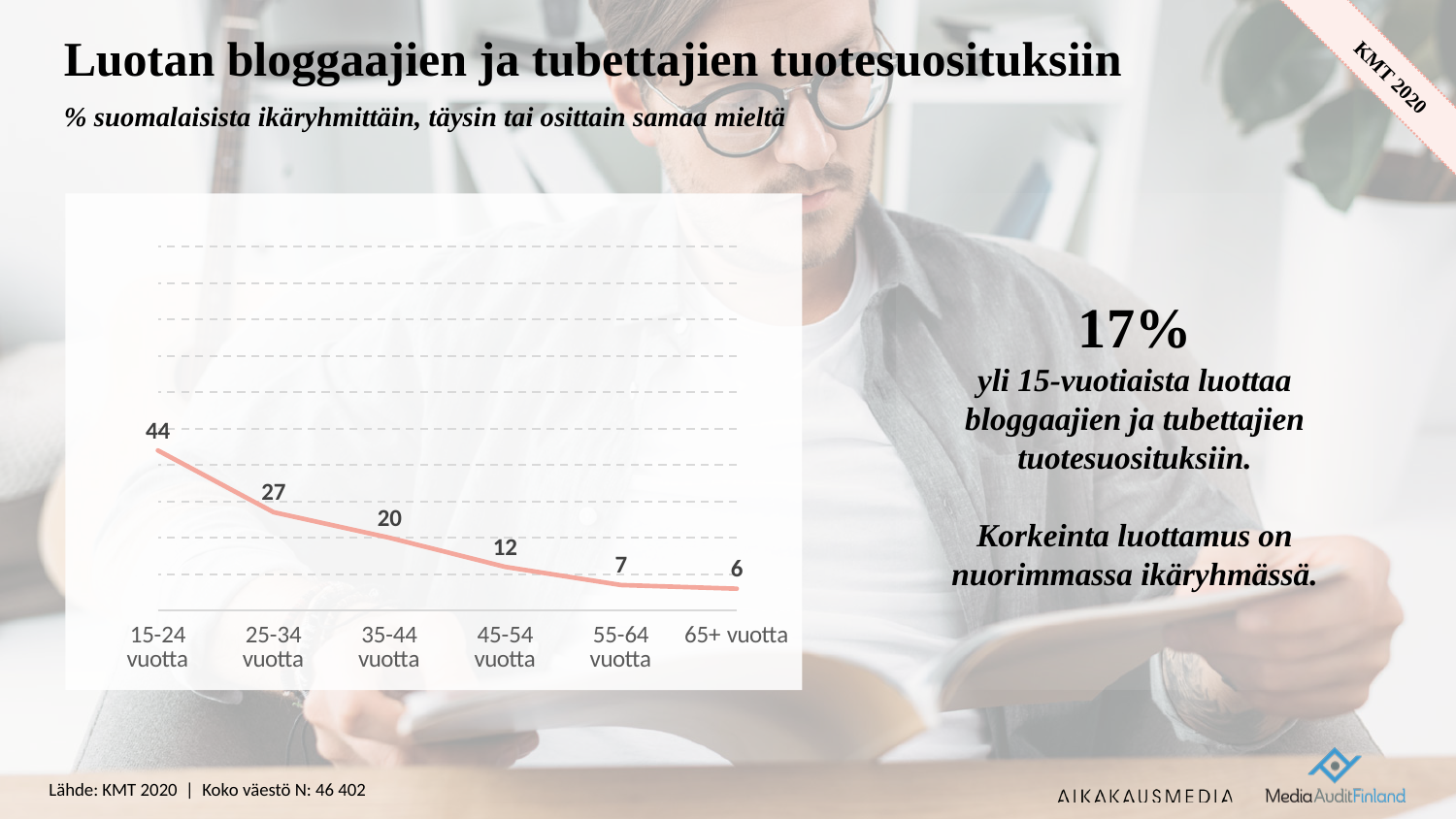
What is the value for the 65+ vuotta age group? 6 What is the value for the 15-24 vuotta age group? 44 Which age group has the highest value? 15-24 vuotta What kind of chart is shown on the slide? line chart Which is larger, the value for 25-34 vuotta or the value for 35-44 vuotta? 25-34 vuotta How many age groups are plotted on the chart? 6 Do the values rise or fall as age increases along the x axis? fall What is the title of the chart on the slide? Luotan bloggaajien ja tubettajien tuotesuosituksiin Which age group has the lowest value? 65+ vuotta What is the difference between the values for 45-54 vuotta and 55-64 vuotta? 5 What is the value for the 35-44 vuotta age group? 20 What is the difference between the values for 15-24 vuotta and 25-34 vuotta? 17